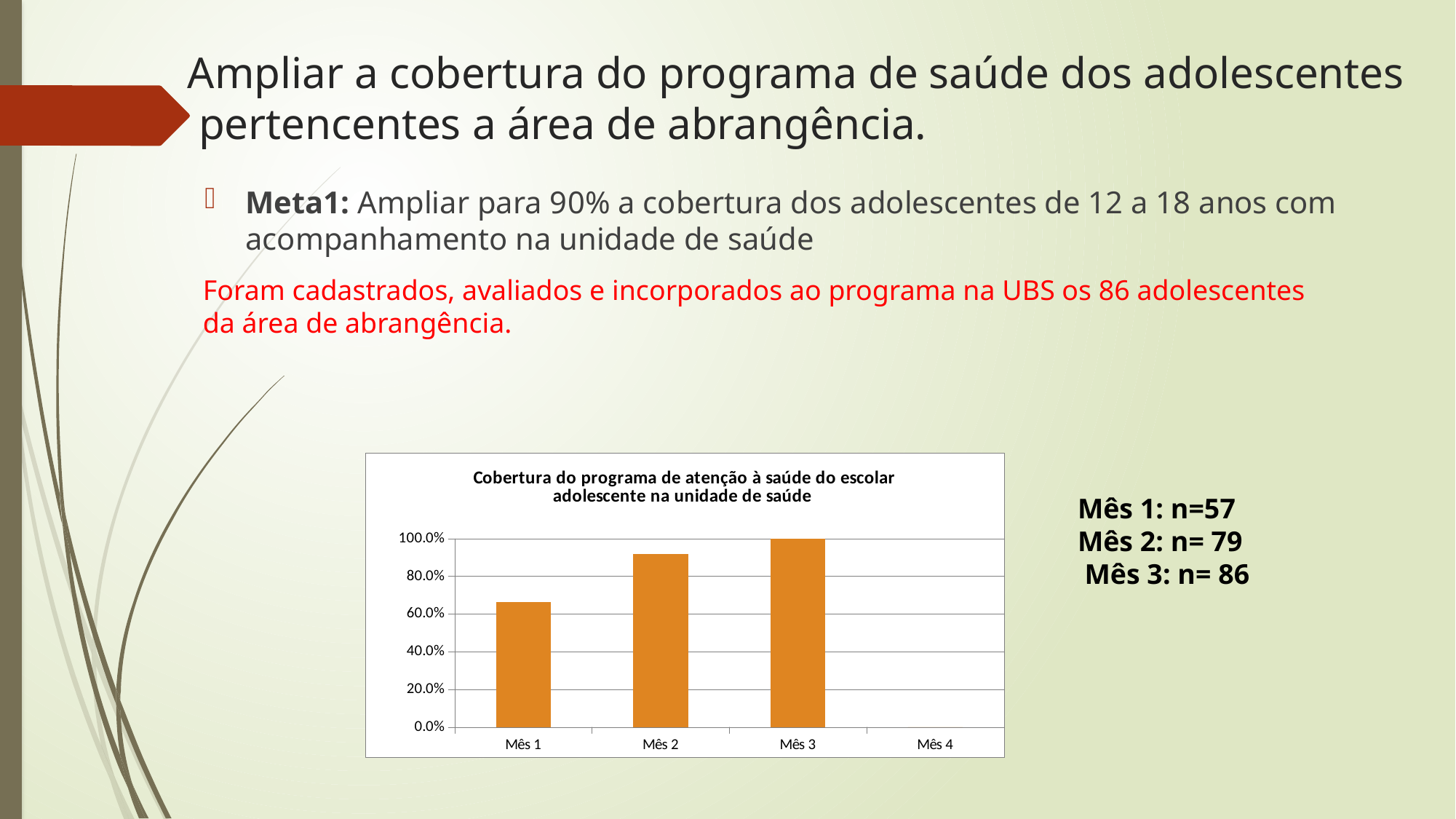
Is the coverage value for Mês 2 greater or less than 100.0%? less Is the coverage value for Mês 2 greater or less than 80.0%? greater How many months (categories) are shown on the x axis of the chart? 4 Among Mês 1, Mês 2 and Mês 3, which month has the lowest coverage? Mês 1 What is the highest tick value shown on the chart's y axis? 100.0% Do the coverage values rise or fall from Mês 1 to Mês 3? rise What kind of chart is shown on the slide? bar chart Which has a higher coverage value, Mês 1 or Mês 2? Mês 2 Which month has the highest coverage in the chart? Mês 3 Is the coverage value for Mês 1 greater or less than 80.0%? less What is the title of the chart? Cobertura do programa de atenção à saúde do escolar adolescente na unidade de saúde